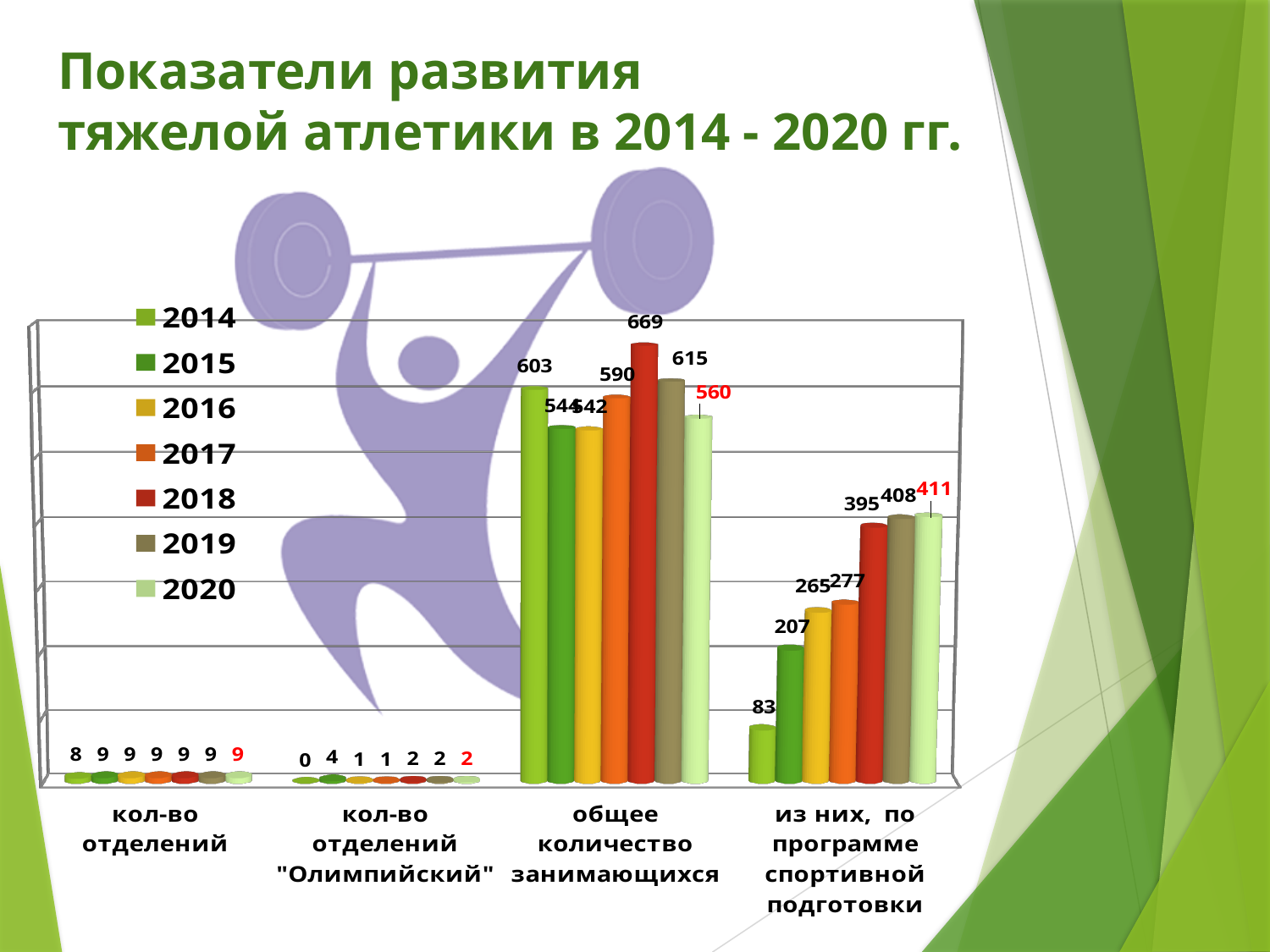
Do the values in the category "из них, по программе спортивной подготовки" rise or fall from 2014 to 2020? rise What kind of chart is shown on the slide? bar chart Which year has the highest value in the category "общее количество занимающихся"? 2018 What is the value for 2020 in the category "общее количество занимающихся"? 560 Which year has the lowest value in the category "из них, по программе спортивной подготовки"? 2014 What is the value for 2018 in the category "общее количество занимающихся"? 669 How many categories are shown on the x axis? 4 What is the value for 2015 in the category "кол-во отделений "Олимпийский""? 4 What is the value for 2014 in the category "из них, по программе спортивной подготовки"? 83 Which is larger in the category "из них, по программе спортивной подготовки": the value for 2019 or the value for 2016? 2019 How many series does the legend list? 7 What is the difference between the 2018 and 2014 values in the category "общее количество занимающихся"? 66